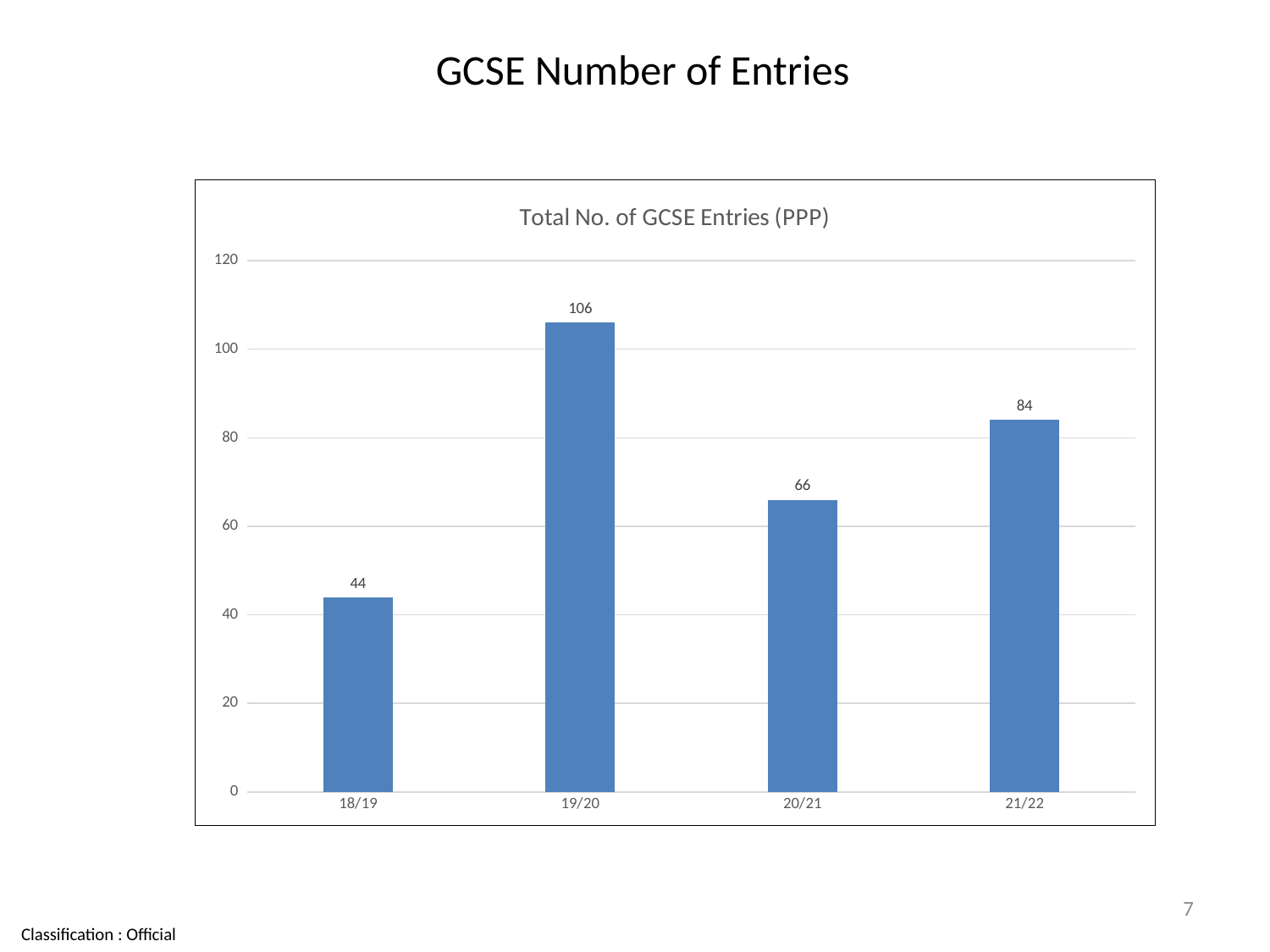
Which year has more GCSE entries, 20/21 or 21/22? 21/22 What is the difference in GCSE entries between 19/20 and 18/19? 62 What is the title of the chart? Total No. of GCSE Entries (PPP) How many years are shown on the chart? 4 What is the difference in GCSE entries between 21/22 and 20/21? 18 What is the total number of GCSE entries for 19/20? 106 Which year has the lowest number of GCSE entries? 18/19 What is the total number of GCSE entries for 20/21? 66 Which year has the highest number of GCSE entries? 19/20 What type of chart is shown on the slide? Bar chart What is the total number of GCSE entries for 18/19? 44 What is the total number of GCSE entries for 21/22? 84